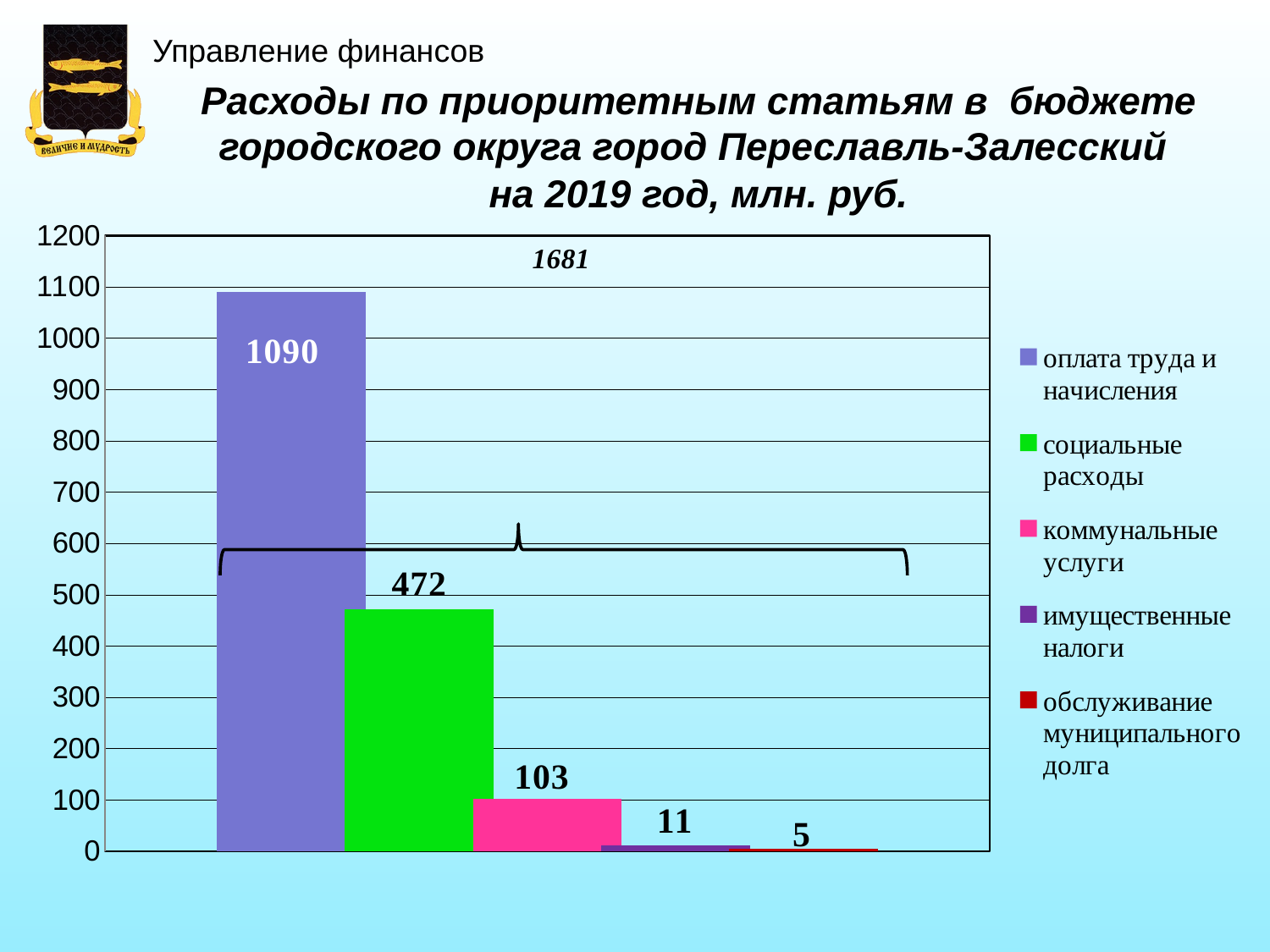
What is the value for обслуживание муниципального долга? 5 Which category has the lowest value? обслуживание муниципального долга What is the difference between оплата труда и начисления and социальные расходы? 618 Which category has the highest value? оплата труда и начисления What is the value for коммунальные услуги? 103 What is the value for оплата труда и начисления? 1090 Which is larger, коммунальные услуги or имущественные налоги? коммунальные услуги What is the value for имущественные налоги? 11 What total is printed above the bars on the chart? 1681 What is the value for социальные расходы? 472 How many categories does the legend list? 5 What kind of chart is shown on the slide? bar chart